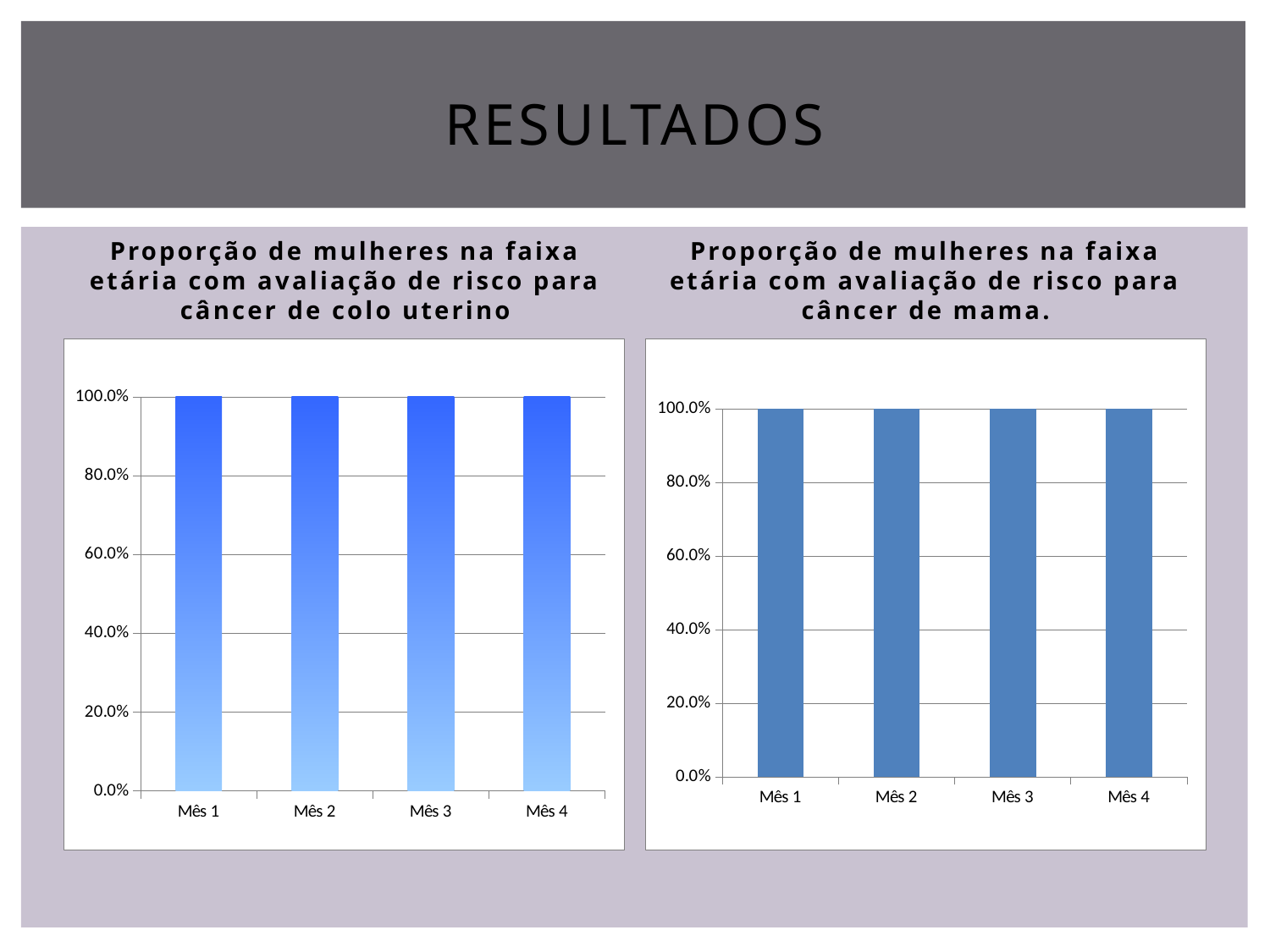
In the right chart (câncer de mama), do the values rise, fall or stay the same from Mês 1 to Mês 4? Stay the same In the left chart (câncer de colo uterino), is the value for Mês 2 greater or less than 80.0%? greater In the left chart (câncer de colo uterino), what is the difference between the values for Mês 1 and Mês 4? 0.0% What kind of chart is the right chart (câncer de mama)? Bar chart How many bars does the right chart (câncer de mama) have? 4 What kind of chart is the left chart (câncer de colo uterino)? Bar chart How many categories are shown on the x axis of the left chart (câncer de colo uterino)? 4 In the left chart (câncer de colo uterino), what is the value for Mês 1? 100.0% In the right chart (câncer de mama), what is the value for Mês 4? 100.0% In the left chart (câncer de colo uterino), what is the value for Mês 3? 100.0% What is the title of the right chart? Proporção de mulheres na faixa etária com avaliação de risco para câncer de mama. In the right chart (câncer de mama), what is the value for Mês 2? 100.0%